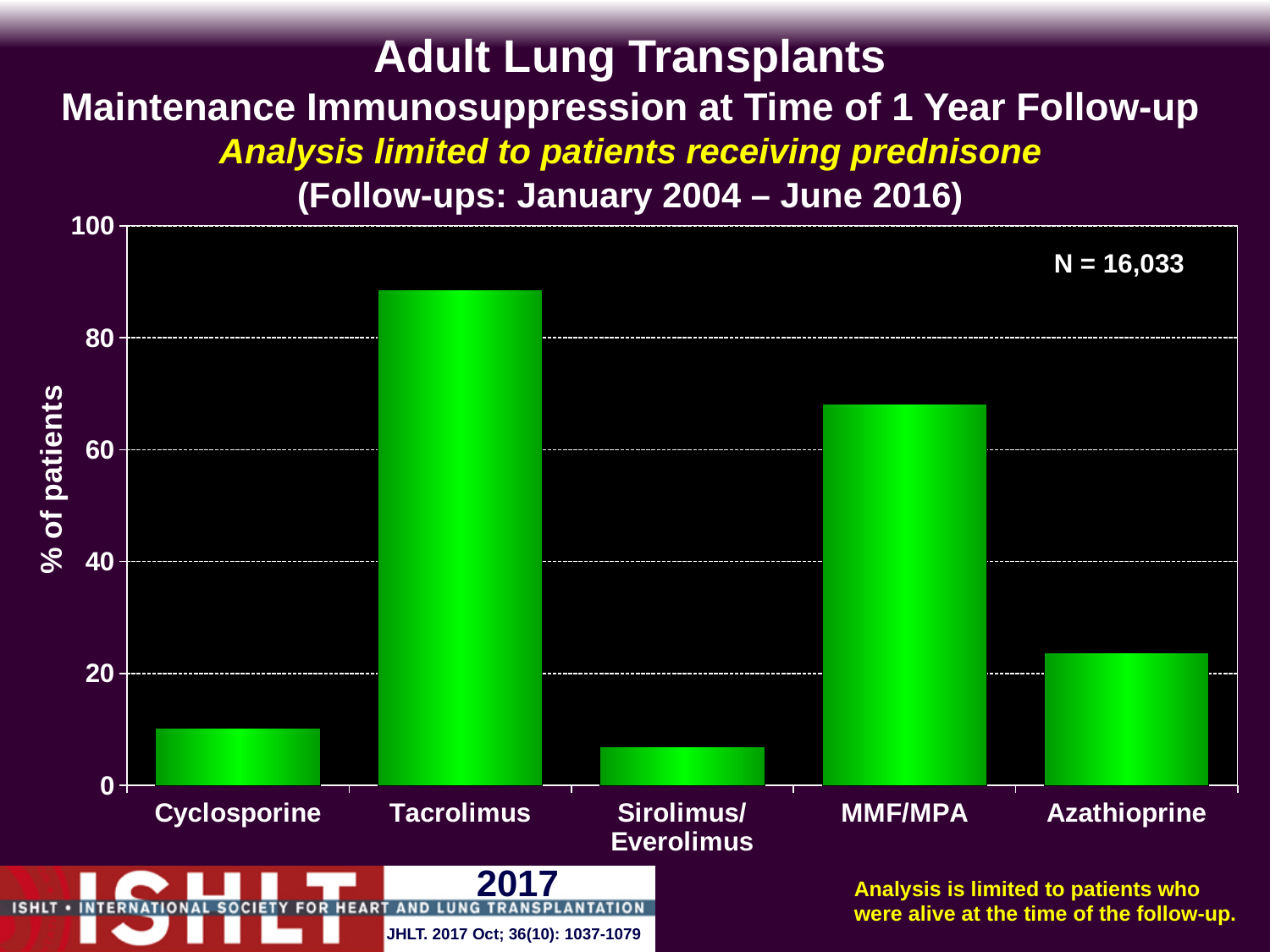
Which category has the lowest bar in the chart? Sirolimus/Everolimus Is the value for Tacrolimus greater or less than 80? greater What is the label of the y axis? % of patients Which category has the highest bar in the chart? Tacrolimus What kind of chart is shown on the slide? bar chart How many categories are shown on the x axis of the chart? 5 Is the value for MMF/MPA greater or less than 60? greater What is the N value shown on the chart? N = 16,033 Is the value for Azathioprine greater or less than 40? less Which is larger, the value for MMF/MPA or the value for Azathioprine? MMF/MPA Which is larger, the value for Cyclosporine or the value for Azathioprine? Azathioprine